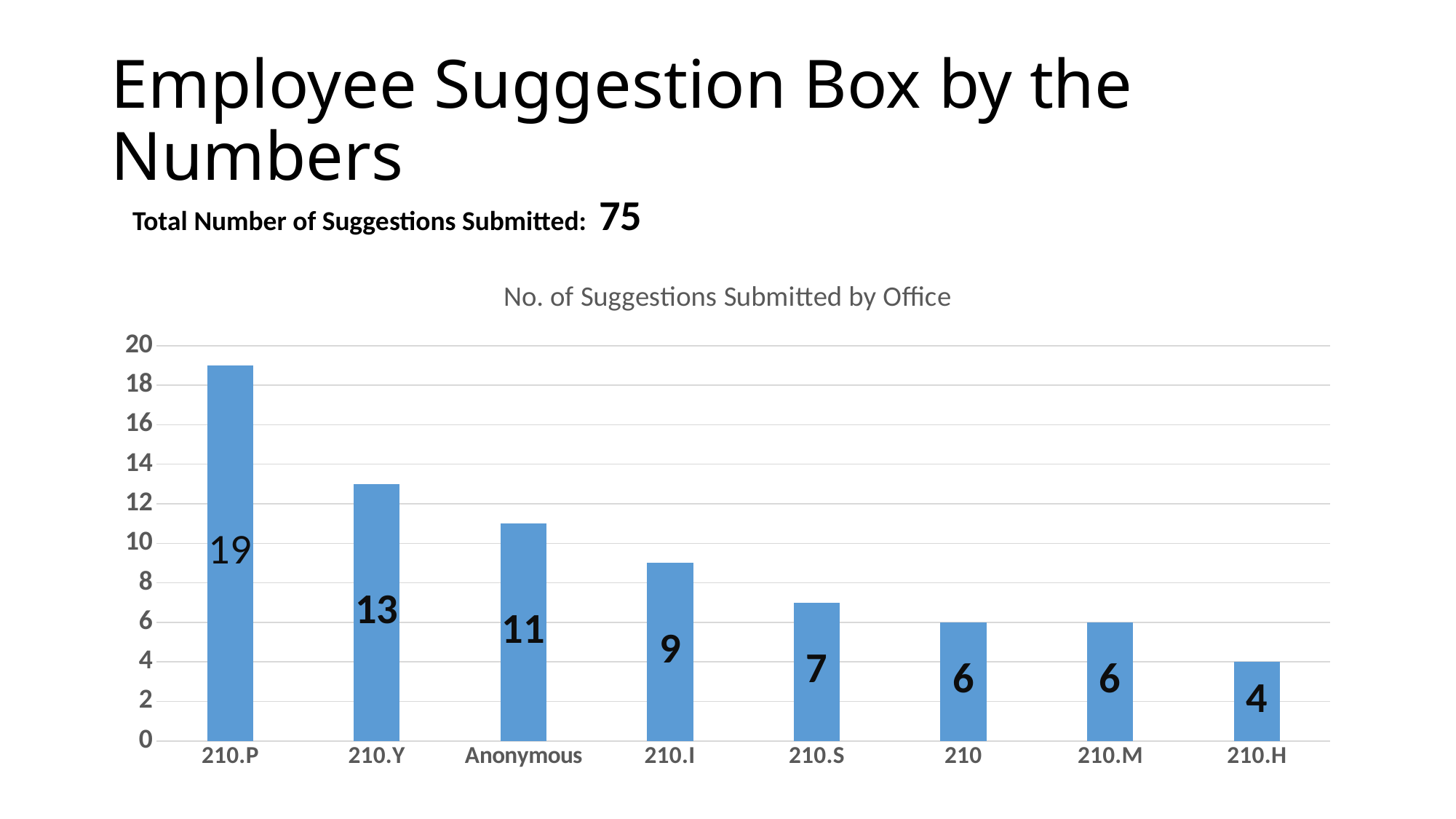
Which office submitted the fewest suggestions? 210.H Which submitted more suggestions, 210.I or 210.S? 210.I What is the title of the chart? No. of Suggestions Submitted by Office How many suggestions were submitted anonymously? 11 Do the values rise or fall from left to right along the x axis? Fall What kind of chart is shown on the slide? Bar chart What is the difference between the number of suggestions from 210.P and 210.Y? 6 Which office submitted the most suggestions? 210.P How many suggestions were submitted by office 210.H? 4 Is the value for 210.Y greater or less than 10? greater How many suggestions were submitted by office 210.P? 19 How many categories are shown on the x axis of the chart? 8